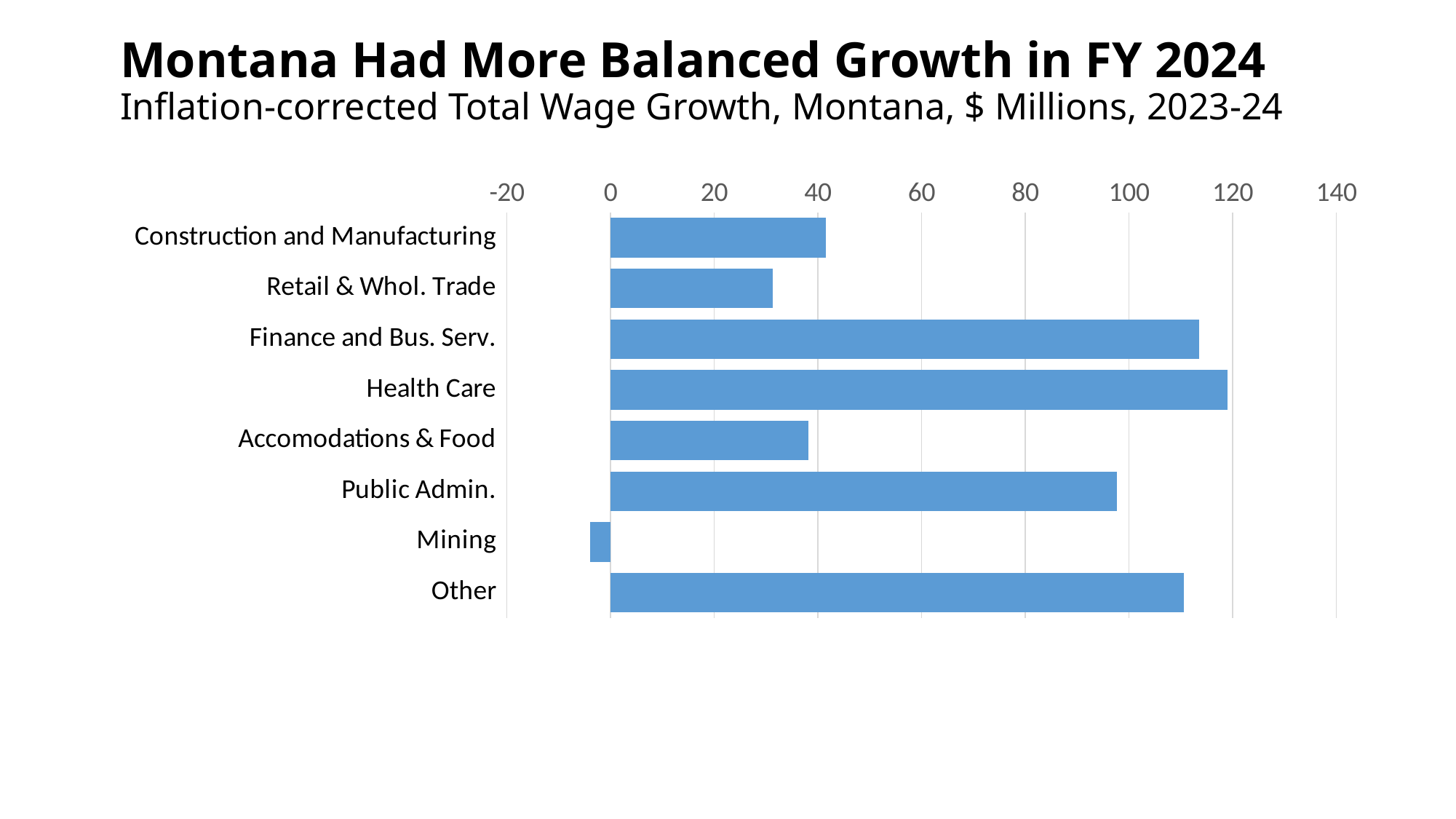
Which has the larger wage growth, Construction and Manufacturing or Retail & Whol. Trade? Construction and Manufacturing Is the value for Mining greater or less than 0? less Which category has the highest inflation-corrected total wage growth? Health Care Is the value for Retail & Whol. Trade greater or less than 40? less What unit are the wage growth values expressed in, according to the subtitle? $ Millions Is the value for Other greater or less than 100? greater What kind of chart is shown on the slide? bar chart Which has the larger wage growth, Finance and Bus. Serv. or Public Admin.? Finance and Bus. Serv. How many industry categories are plotted in the chart? 8 Which category has the lowest inflation-corrected total wage growth? Mining